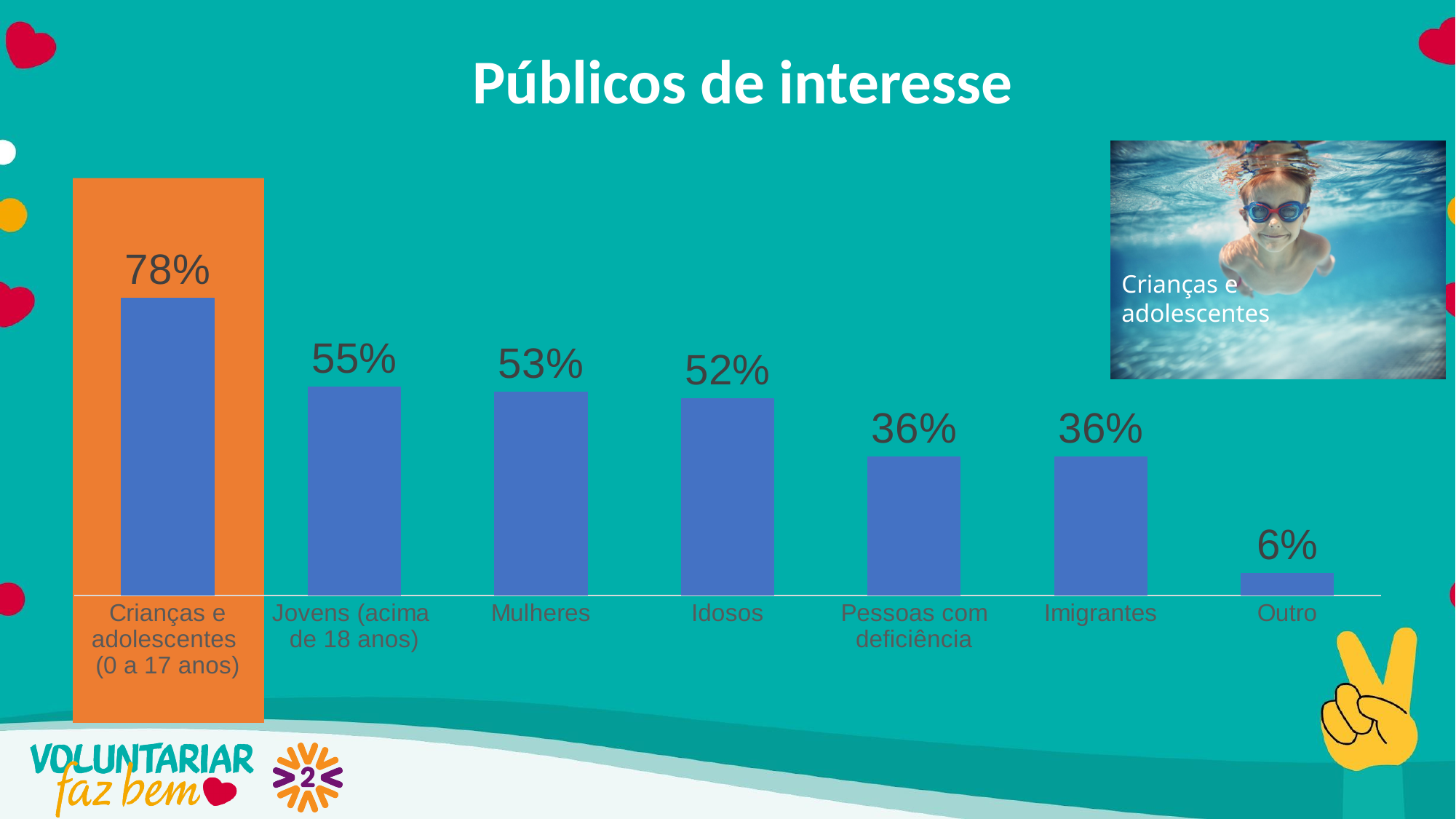
What is the difference between the values for Crianças e adolescentes (0 a 17 anos) and Jovens (acima de 18 anos)? 23% What is the difference between the values for Idosos and Imigrantes? 16% What is the value for Outro? 6% What is the title of the chart? Públicos de interesse Which category has the lowest value? Outro Which category has the highest value? Crianças e adolescentes (0 a 17 anos) What is the value for Pessoas com deficiência? 36% How many categories are shown in the chart? 7 What kind of chart is shown on the slide? Bar chart Which is larger, the value for Jovens (acima de 18 anos) or the value for Idosos? Jovens (acima de 18 anos) What is the value for Mulheres? 53% What is the value for Crianças e adolescentes (0 a 17 anos)? 78%